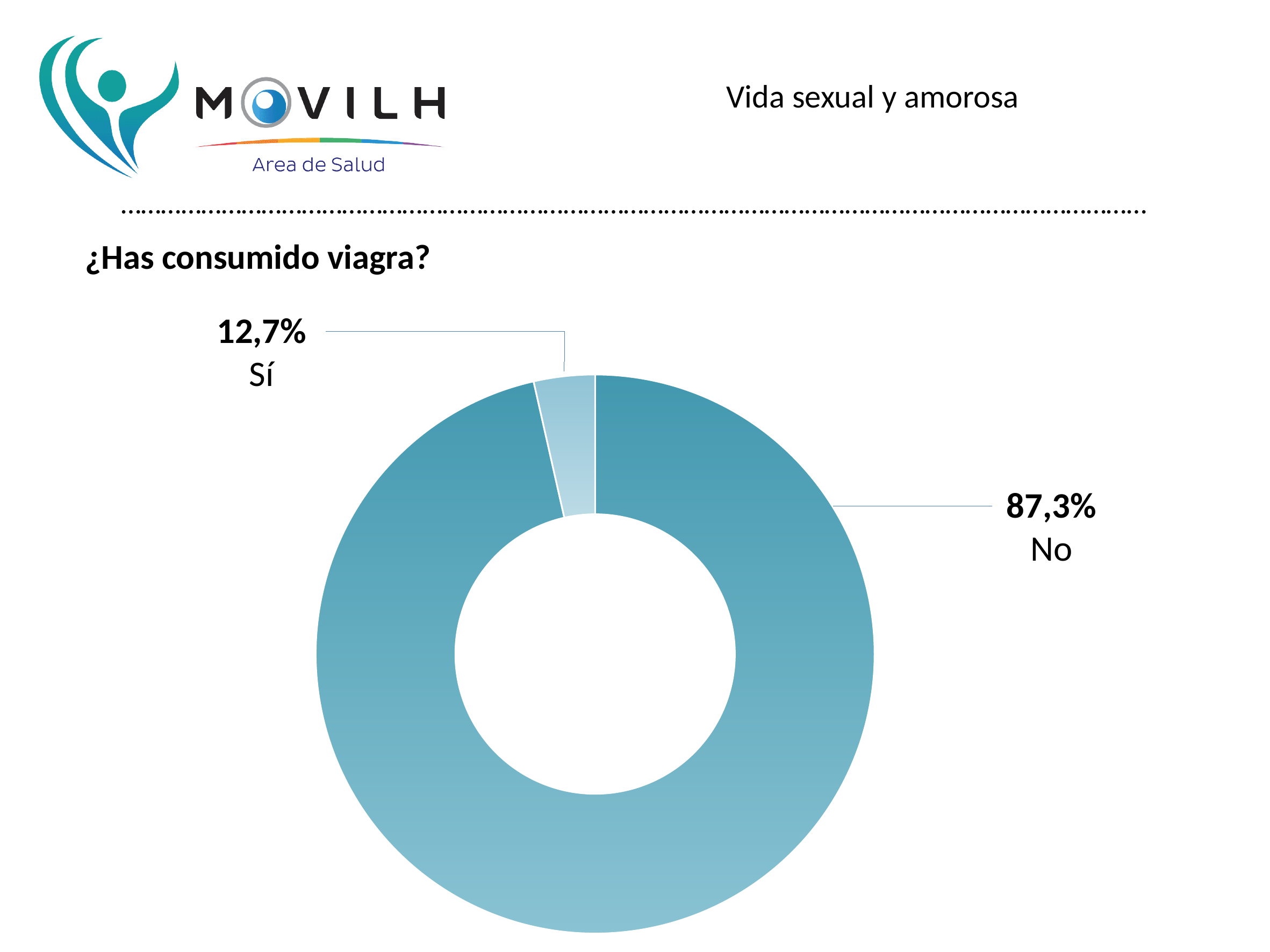
What is the share of the pie taken by the "Sí" slice? 12,7% What percentage of respondents answered "No" to "¿Has consumido viagra?"? 87,3% Which response has the smallest share in the chart? Sí What question does the chart title ask? ¿Has consumido viagra? What percentage of respondents answered "Sí" to "¿Has consumido viagra?"? 12,7% Which share is larger, "Sí" or "No"? No Which slice is shown in the lighter colour, "Sí" or "No"? Sí What is the difference in percentage points between the "No" and "Sí" shares? 74,6 How many categories are shown in the chart? 2 Which response has the largest share in the chart? No What kind of chart is shown on the slide? Pie chart (doughnut)